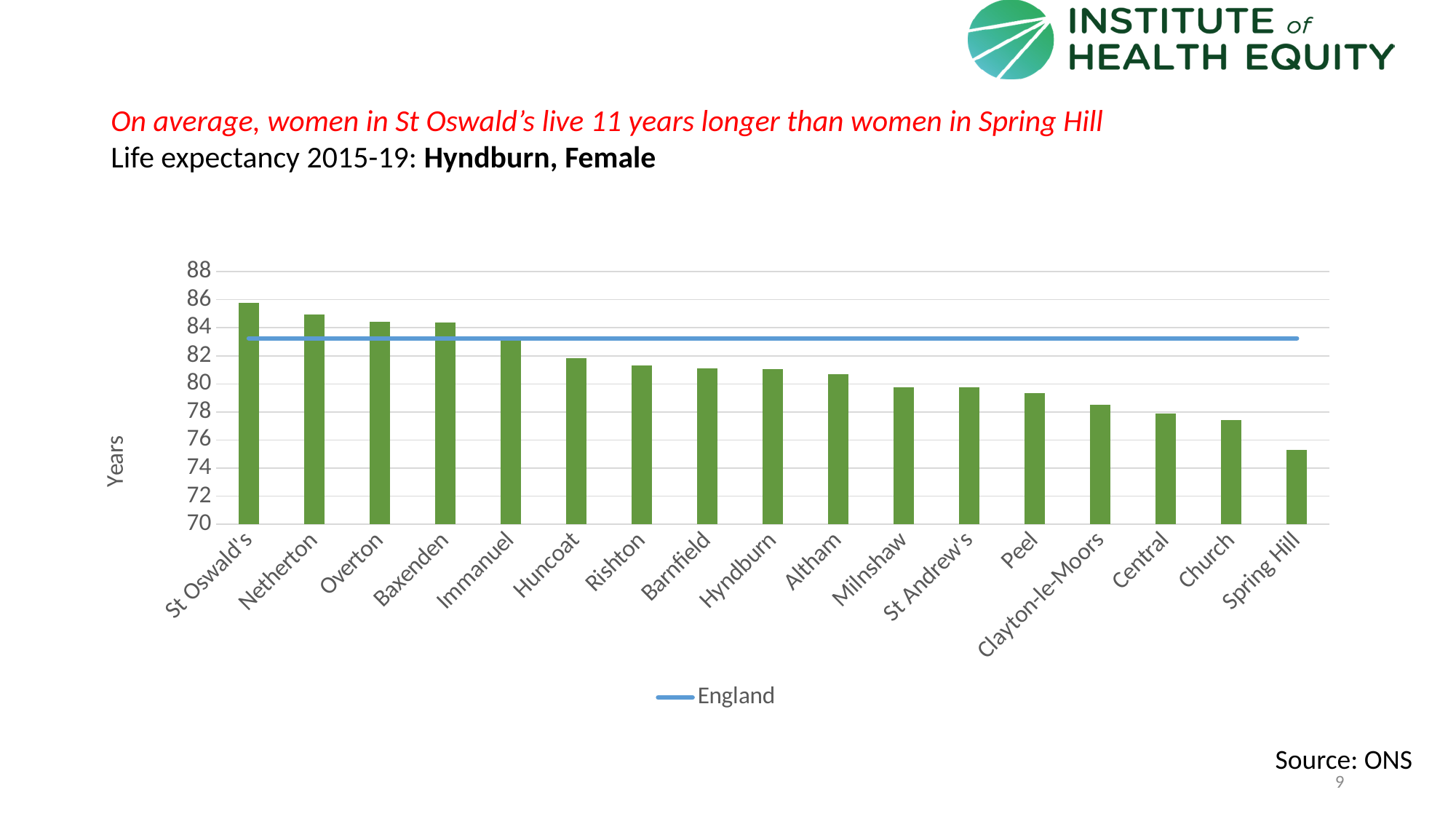
What is the label on the vertical axis of the chart? Years What kind of chart is shown on the slide? Bar chart Which ward has the highest female life expectancy in the chart? St Oswald's Is the value for Huncoat greater or less than 80? greater Which has the larger value, Netherton or Peel? Netherton Is the value for St Oswald's greater or less than 84? greater Do the bar values rise or fall moving from left to right along the x axis? Fall Which ward has the lowest female life expectancy in the chart? Spring Hill Is the value for Spring Hill greater or less than 76? less How many wards (bars) are plotted in the chart? 17 What does the horizontal blue line in the chart represent, according to the legend? England